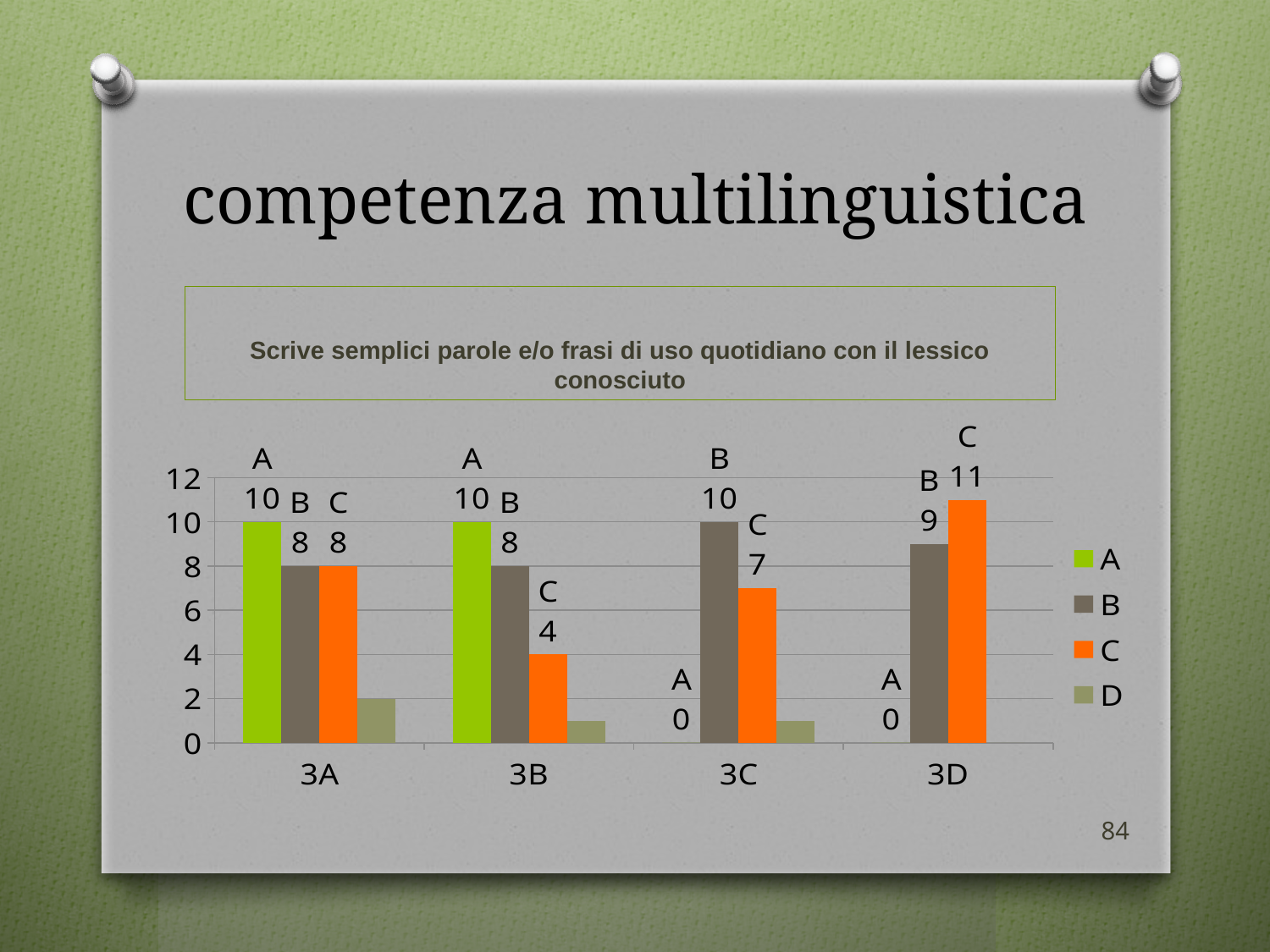
What is the value of series B for category 3D? 9 What kind of chart is shown on the slide? bar chart What is the value of series C for category 3B? 4 How many series does the legend list? 4 For category 3D, which is larger: series B or series C? C Which category has the highest value for series C? 3D Which category has the lowest value for series C? 3B How many categories are shown on the x axis? 4 What is the value of series A for category 3C? 0 What is the value of series A for category 3A? 10 Is the value of series D for category 3A greater or less than 4? less What is the difference between the values of series B and series C for category 3C? 3